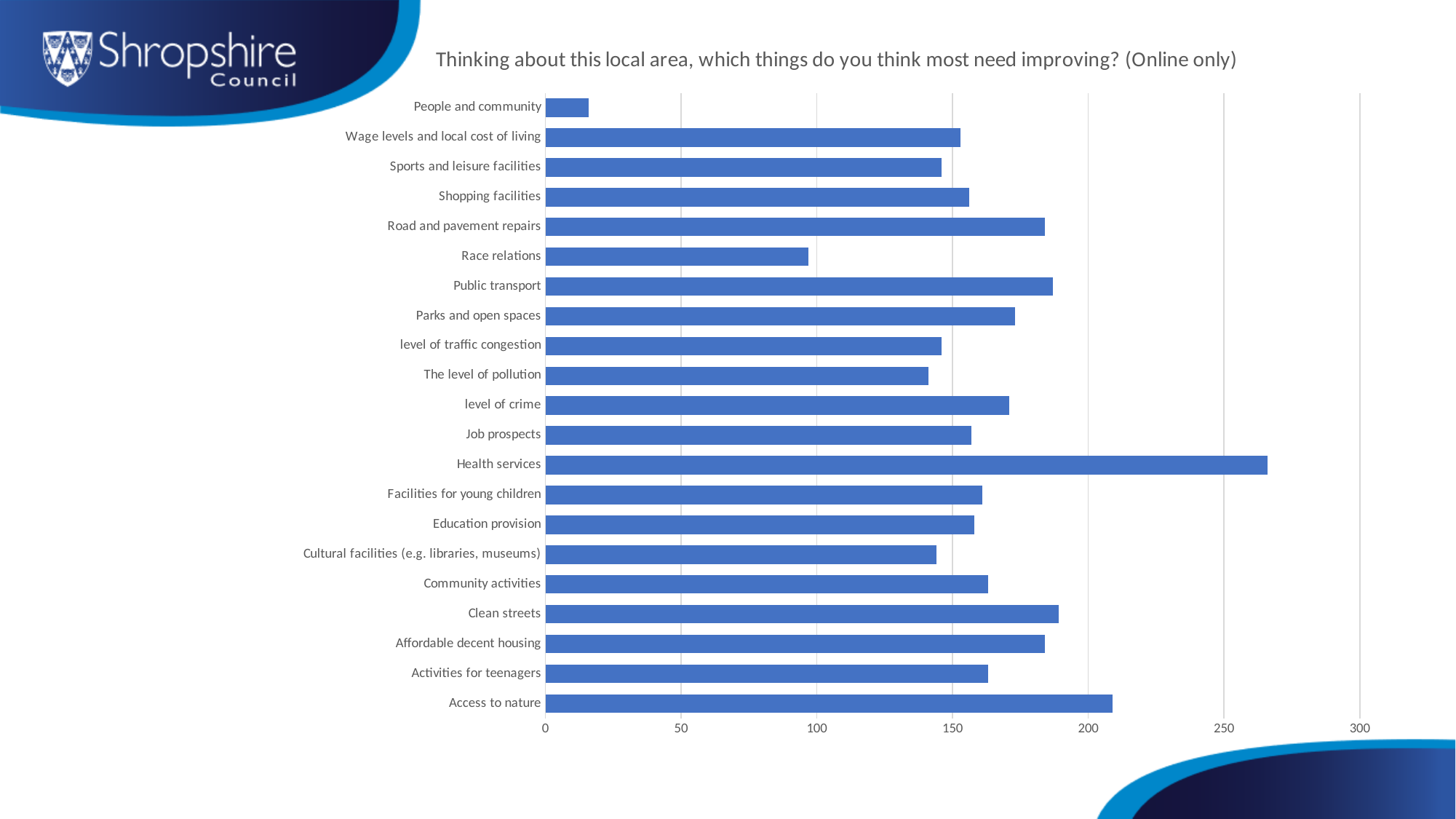
Which is larger, the value for Access to nature or the value for Clean streets? Access to nature Which category has the lowest value? People and community What kind of chart is shown on the slide? bar chart Is the value for People and community greater or less than 50? less What is the title of the chart? Thinking about this local area, which things do you think most need improving? (Online only) Is the value for Access to nature greater or less than 200? greater Is the value for Road and pavement repairs greater or less than 150? greater Which category has the highest value? Health services How many categories are plotted on the chart? 21 Which is larger, the value for Public transport or the value for Race relations? Public transport